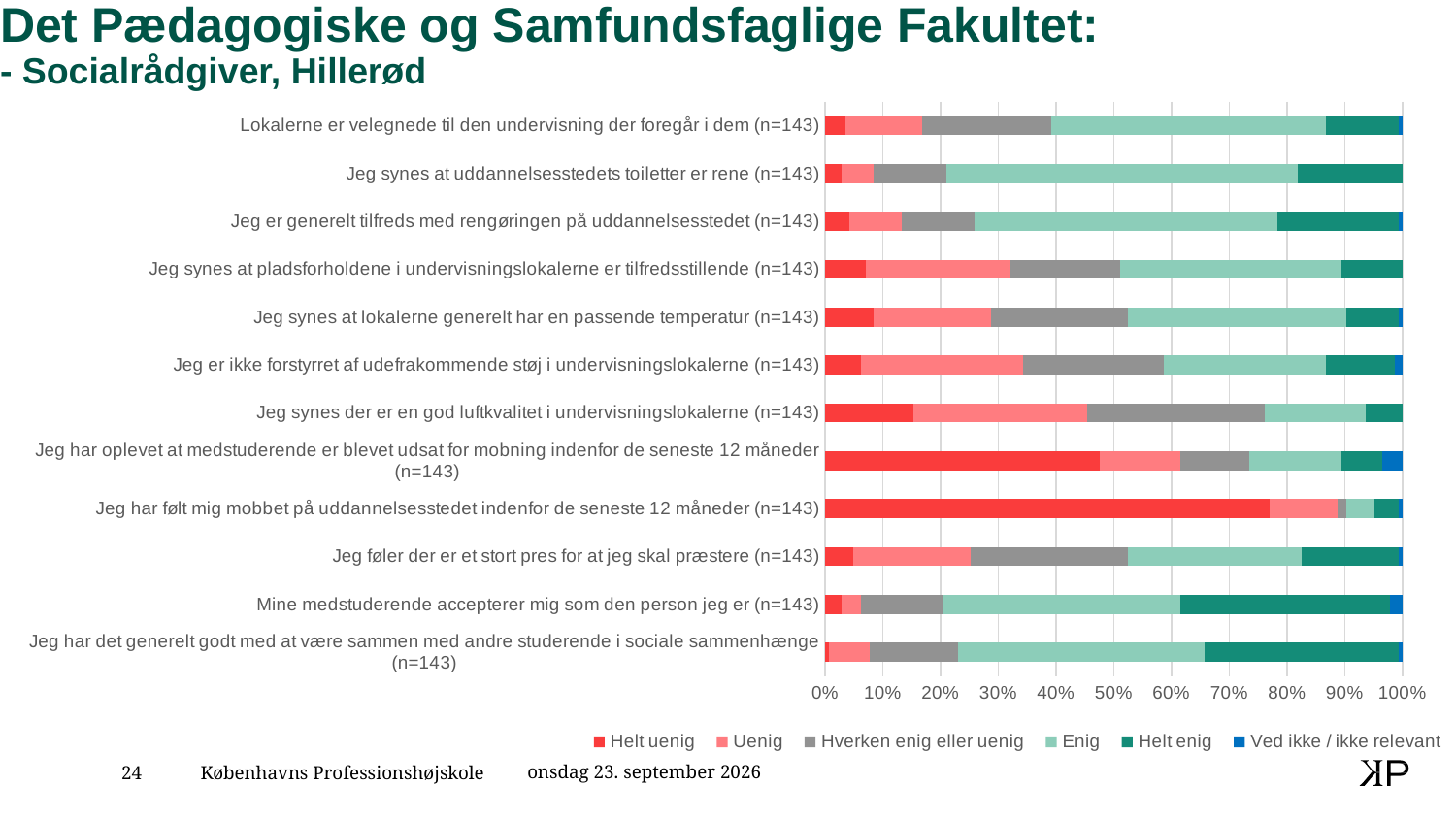
Is the 'Helt uenig' share for 'Jeg har oplevet at medstuderende er blevet udsat for mobning indenfor de seneste 12 måneder' greater or less than 40%? greater Is the 'Helt uenig' share for 'Lokalerne er velegnede til den undervisning der foregår i dem' greater or less than 10%? less How many series does the legend list? 6 Which has a larger 'Helt enig' share: 'Mine medstuderende accepterer mig som den person jeg er' or 'Jeg synes der er en god luftkvalitet i undervisningslokalerne'? Mine medstuderende accepterer mig som den person jeg er Which legend entry is shown in dark green? Helt enig What is the sample size (n) shown for each statement? 143 Which statement has the largest 'Helt uenig' segment? Jeg har følt mig mobbet på uddannelsesstedet indenfor de seneste 12 måneder (n=143) What kind of chart is shown on the slide? Stacked bar chart Is the 'Helt uenig' share for 'Jeg har følt mig mobbet på uddannelsesstedet indenfor de seneste 12 måneder' greater or less than 70%? greater How many statements (categories) are plotted in the chart? 12 Which has a larger 'Helt uenig' share: 'Jeg synes der er en god luftkvalitet i undervisningslokalerne' or 'Jeg synes at uddannelsesstedets toiletter er rene'? Jeg synes der er en god luftkvalitet i undervisningslokalerne What does each stacked bar in the chart total? 100%